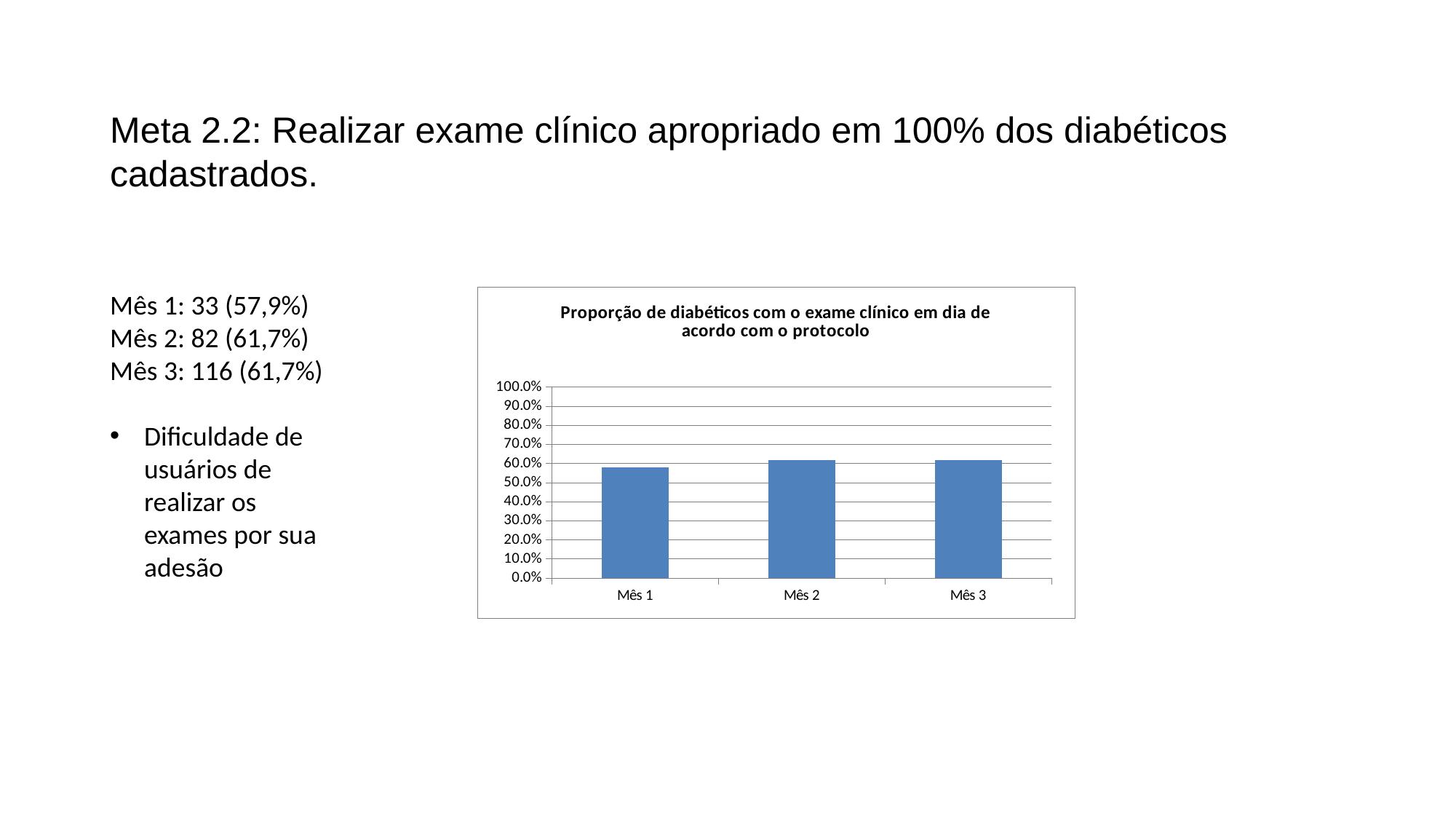
What kind of chart is shown on the slide? bar chart Is the value for Mês 1 greater or less than 60%? less Do the values rise or fall from Mês 1 to Mês 3? rise Is the value for Mês 2 greater or less than 60%? greater How many months (categories) are plotted in the chart? 3 What is the highest value shown on the vertical axis of the chart? 100.0% Which is larger, the value for Mês 1 or the value for Mês 2? Mês 2 According to the slide, what proportion is shown for Mês 1? 57,9% Which month has the lowest proportion in the chart? Mês 1 What is the title of the chart? Proporção de diabéticos com o exame clínico em dia de acordo com o protocolo Is the value for Mês 3 greater or less than 70%? less According to the slide, what proportion is shown for Mês 3? 61,7%